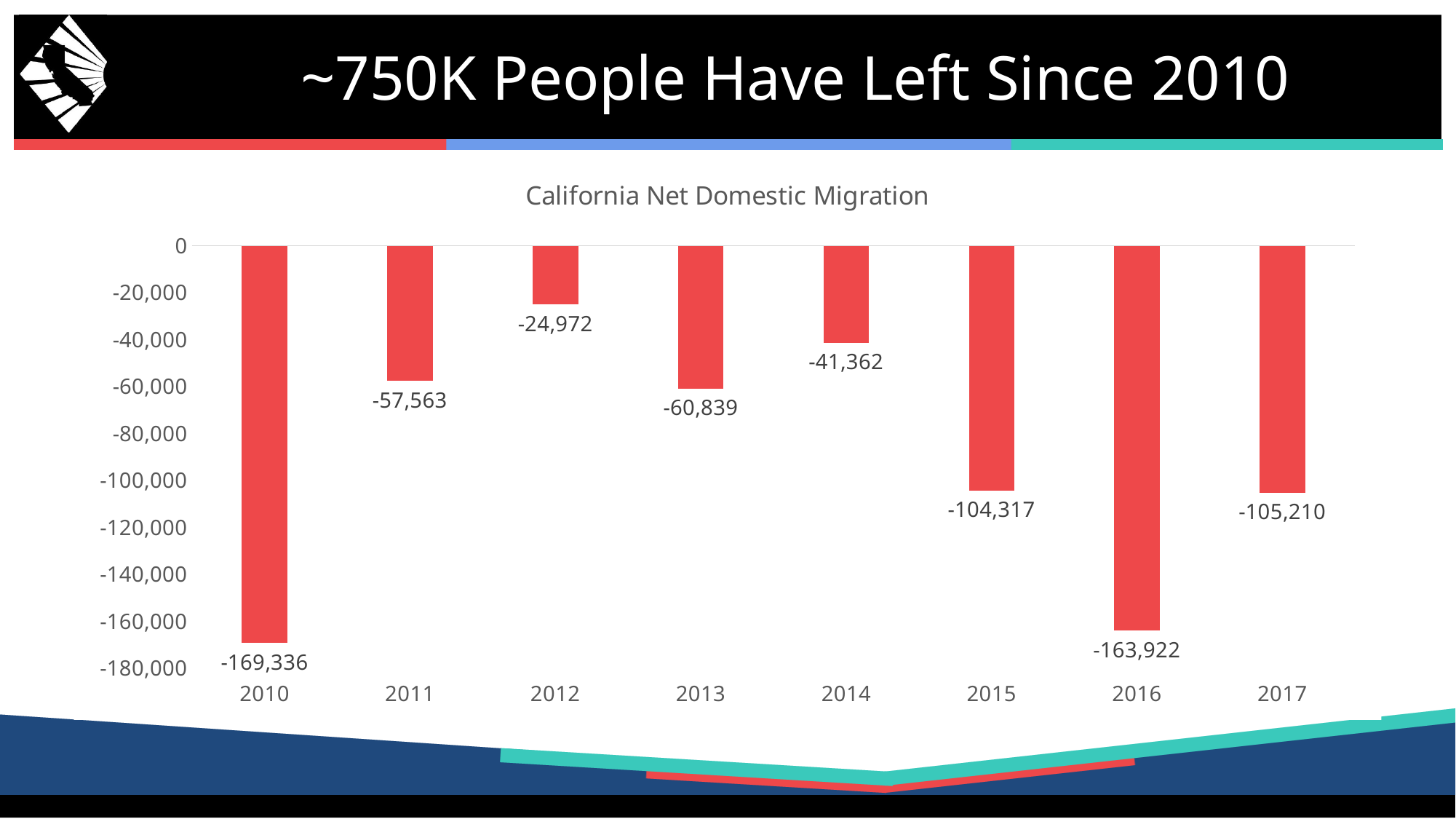
What is the value for 2014 in the California Net Domestic Migration chart? -41,362 What is the value for 2010 in the California Net Domestic Migration chart? -169,336 What is the value for 2012 in the California Net Domestic Migration chart? -24,972 What is the value for 2016 in the California Net Domestic Migration chart? -163,922 What kind of chart is shown on the slide? Bar chart Which year has the most negative net domestic migration value in the chart? 2010 By how much does the 2013 value differ from the 2011 value in the chart? 3,276 What is the title of the chart on the slide? California Net Domestic Migration Which year has a more negative value, 2011 or 2014? 2011 Which year has the net domestic migration value closest to zero in the chart? 2012 How many years are shown on the x axis of the chart? 8 By how much does the 2010 value differ from the 2016 value in the chart? 5,414